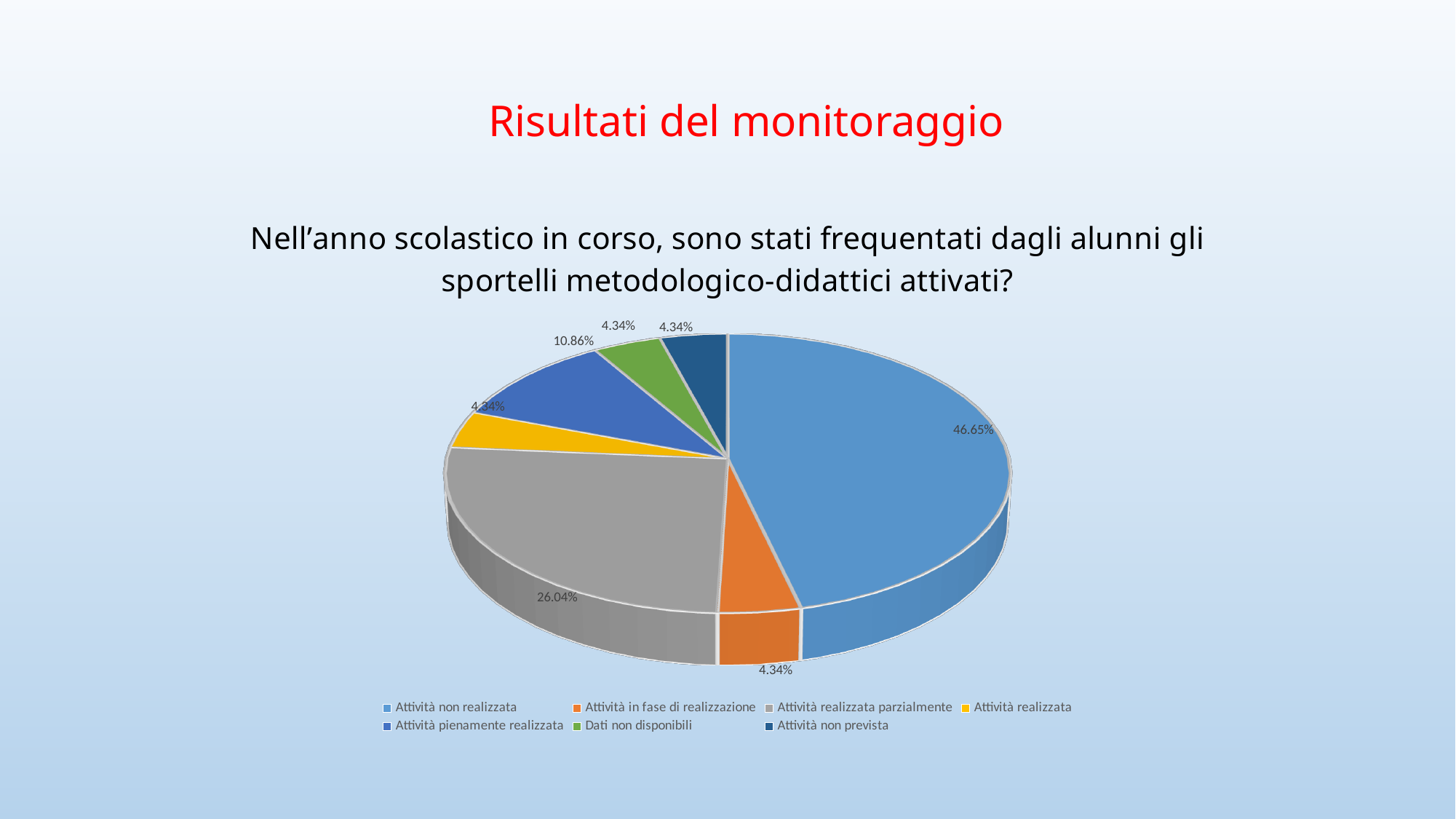
Which category has the largest slice of the pie? Attività non realizzata Which is larger: the share for "Attività realizzata parzialmente" or the share for "Attività pienamente realizzata"? Attività realizzata parzialmente How many slices does the pie chart have? 7 What share of the pie does "Attività pienamente realizzata" represent? 10.86% What share of the pie does "Attività non realizzata" represent? 46.65% What share of the pie does "Attività in fase di realizzazione" represent? 4.34% What share of the pie does "Dati non disponibili" represent? 4.34% What share of the pie does "Attività realizzata parzialmente" represent? 26.04% What kind of chart is shown on the slide? Pie chart What colour is the slice for "Attività realizzata"? Yellow What is the difference between the shares of "Attività non realizzata" and "Attività realizzata parzialmente"? 20.61% What is the difference between the shares of "Attività pienamente realizzata" and "Attività realizzata"? 6.52%